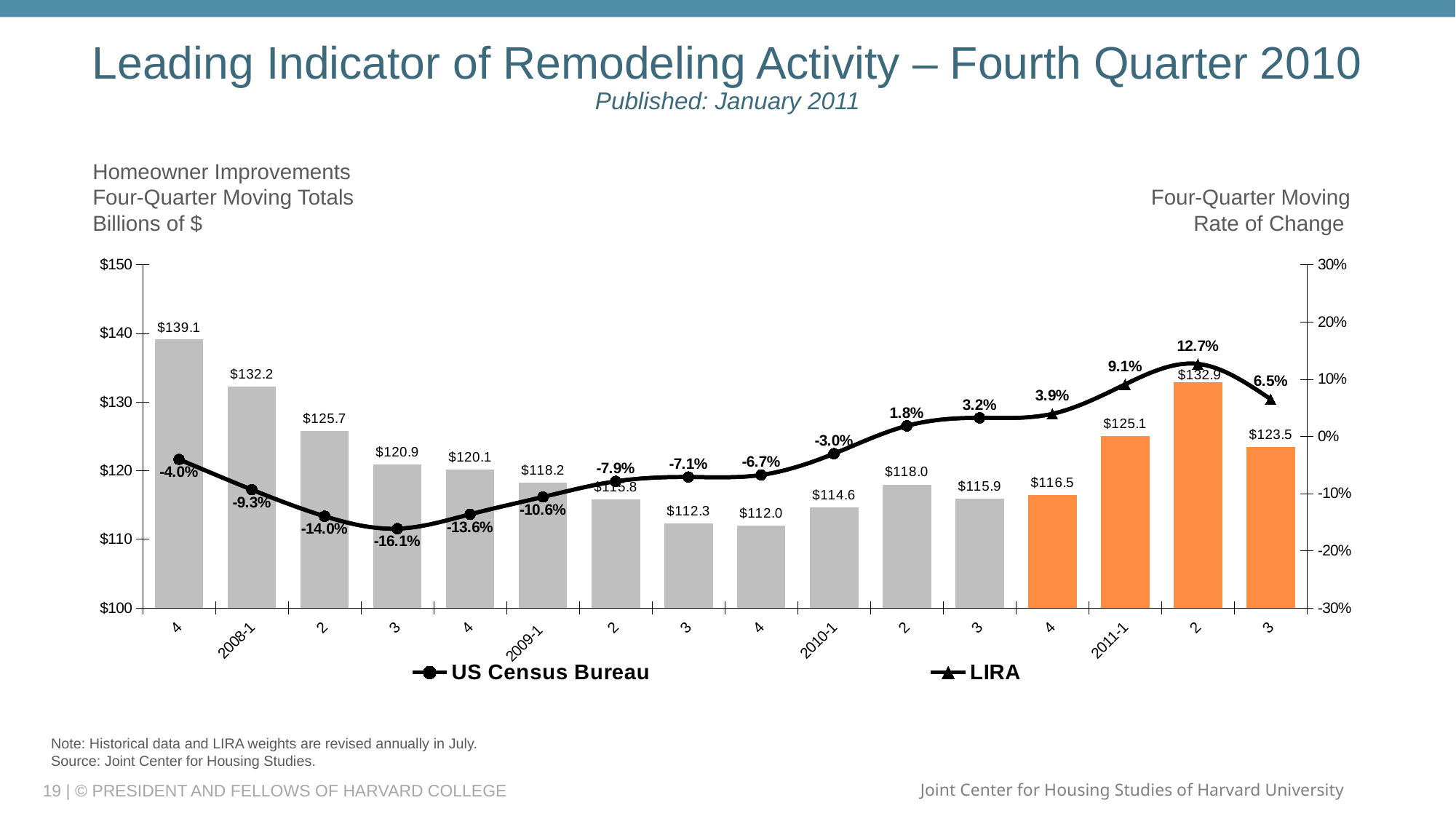
What is the value of the bar for 2011-1? $125.1 What is the value of the Homeowner Improvements bar for 2008-1? $132.2 Does the rate of change line rise or fall from 2010-1 to 2011-2? rise What is the four-quarter moving rate of change shown for 2010-1? -3.0% What is the lowest rate of change value shown on the line? -16.1% What is the difference between the bar values for 2011-1 and 2010-1? $10.5 How many bars are plotted on the chart? 16 How many series does the legend list? 2 What is the highest rate of change value shown on the line? 12.7% Which has the larger bar value, 2009-1 or 2010-1? 2009-1 What is the highest bar value shown on the chart? $139.1 What is the lowest bar value shown on the chart? $112.0